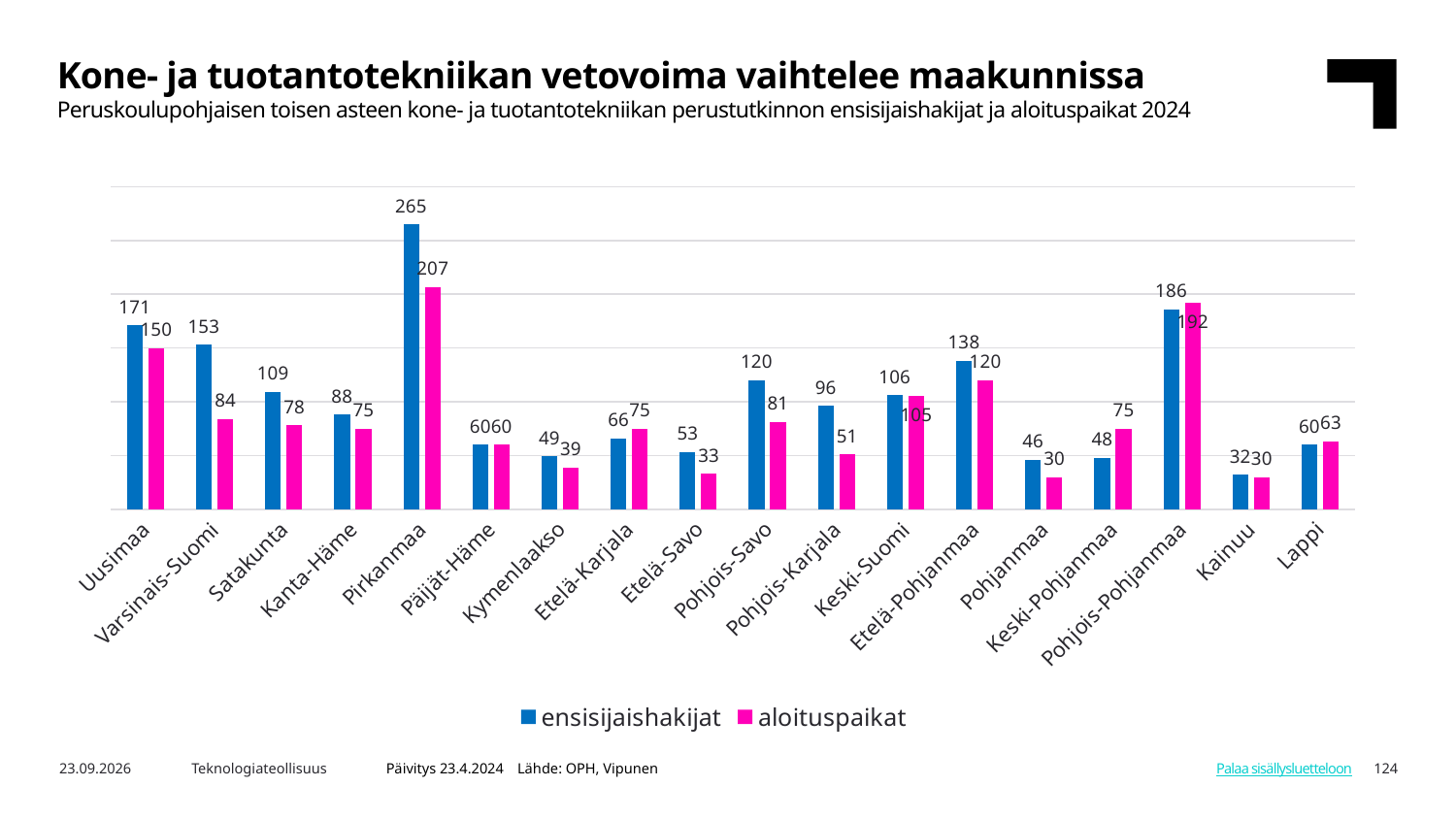
Which region has the lowest value of aloituspaikat? Pohjanmaa and Kainuu (30) Which is larger for Keski-Pohjanmaa: ensisijaishakijat or aloituspaikat? aloituspaikat How many regions are shown on the x axis? 18 Which region has the highest value of ensisijaishakijat? Pirkanmaa What is the difference between ensisijaishakijat and aloituspaikat for Pohjois-Savo? 39 What are the two series named in the legend? ensisijaishakijat and aloituspaikat Which is larger: ensisijaishakijat for Uusimaa or ensisijaishakijat for Varsinais-Suomi? Uusimaa What is the value of aloituspaikat for Varsinais-Suomi? 84 How many series does the legend list? 2 What is the value of ensisijaishakijat for Pirkanmaa? 265 What is the value of aloituspaikat for Pohjois-Pohjanmaa? 192 What kind of chart is shown on the slide? bar chart